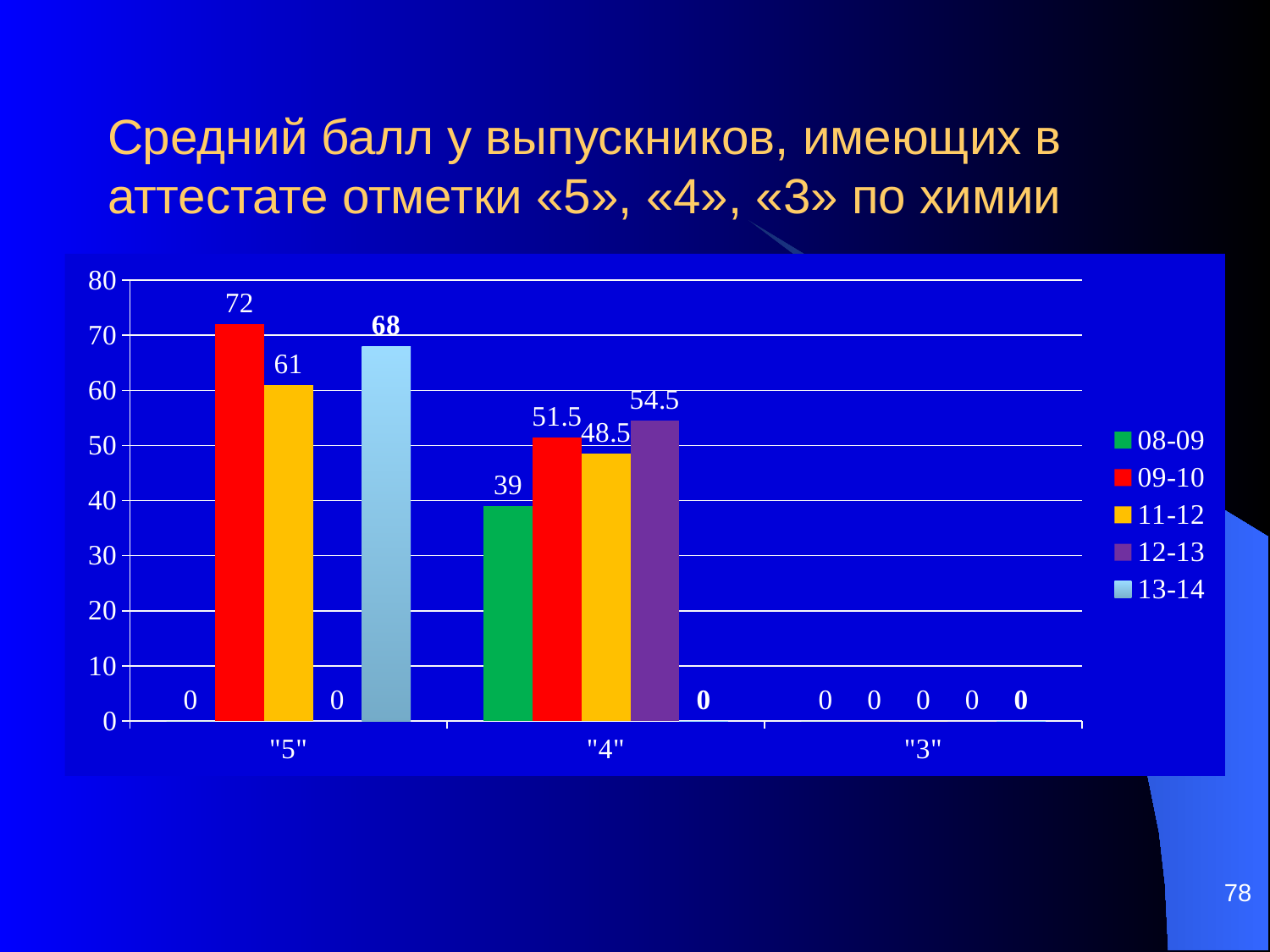
What is the value for the 13-14 series in the "5" category? 68 How many series does the legend list? 5 What is the difference between the 09-10 and 11-12 values in the "5" category? 11 How many categories are shown on the x axis? 3 Which series has the lowest non-zero value in the "4" category? 08-09 What is the value for the 12-13 series in the "4" category? 54.5 What is the value for the 09-10 series in the "5" category? 72 What is the value for the 08-09 series in the "4" category? 39 What kind of chart is shown on the slide? Bar chart What colour represents the 12-13 series in the legend? Purple Which series has the highest value in the "5" category? 09-10 Which is larger in the "4" category: the 09-10 value or the 11-12 value? 09-10